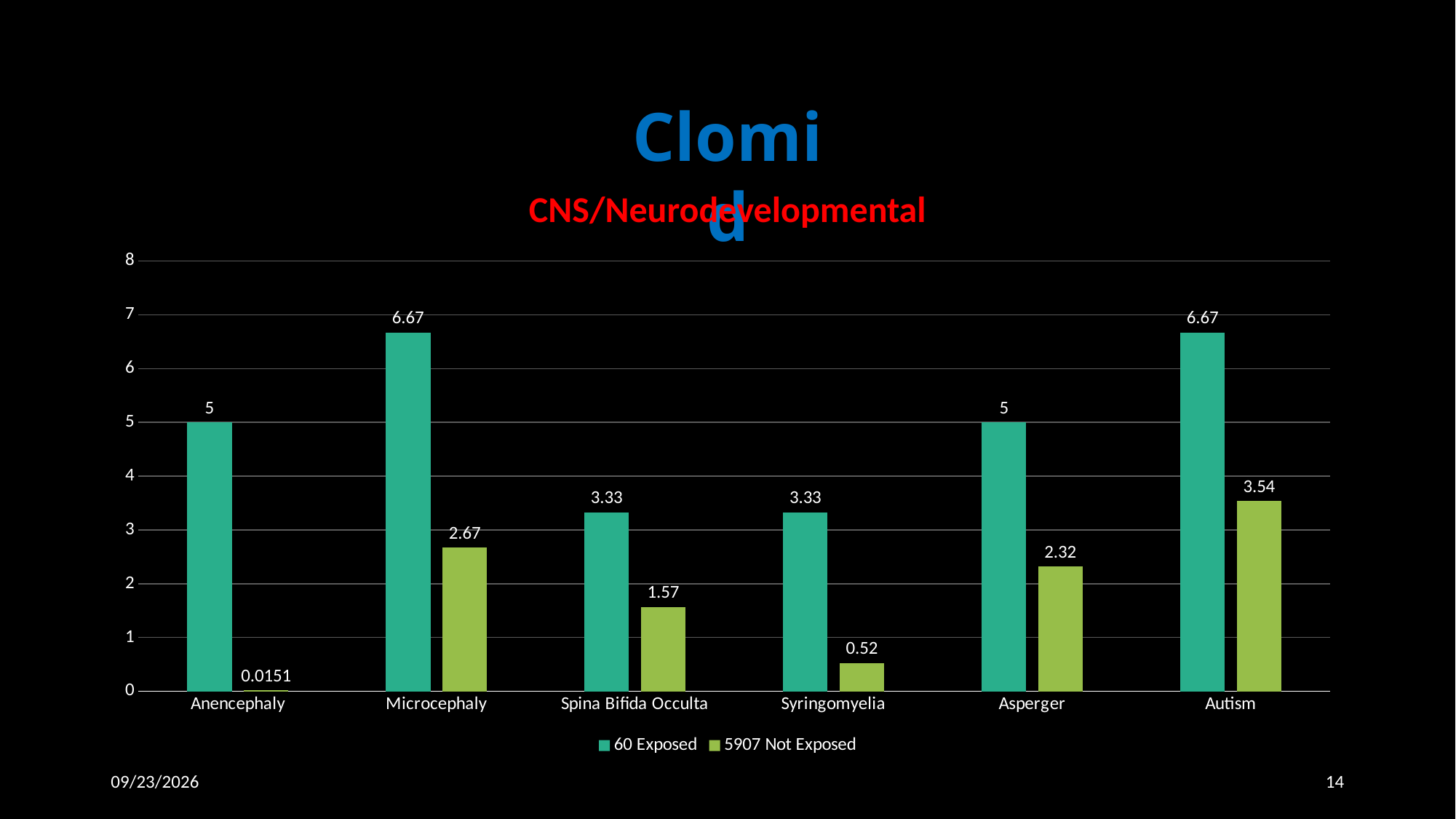
Which is larger for Spina Bifida Occulta: the 60 Exposed value or the 5907 Not Exposed value? 60 Exposed Which category has the highest value in the 5907 Not Exposed series? Autism How many categories are shown on the x axis? 6 What is the value for Microcephaly in the 60 Exposed series? 6.67 What is the difference between the 60 Exposed and 5907 Not Exposed values for Asperger? 2.68 Is the 60 Exposed value for Syringomyelia greater or less than 4? less How many series does the legend list? 2 What is the value for Autism in the 5907 Not Exposed series? 3.54 Which category has the lowest value in the 5907 Not Exposed series? Anencephaly What kind of chart is shown on the slide? Bar chart What is the value for Anencephaly in the 5907 Not Exposed series? 0.0151 What is the value for Syringomyelia in the 5907 Not Exposed series? 0.52